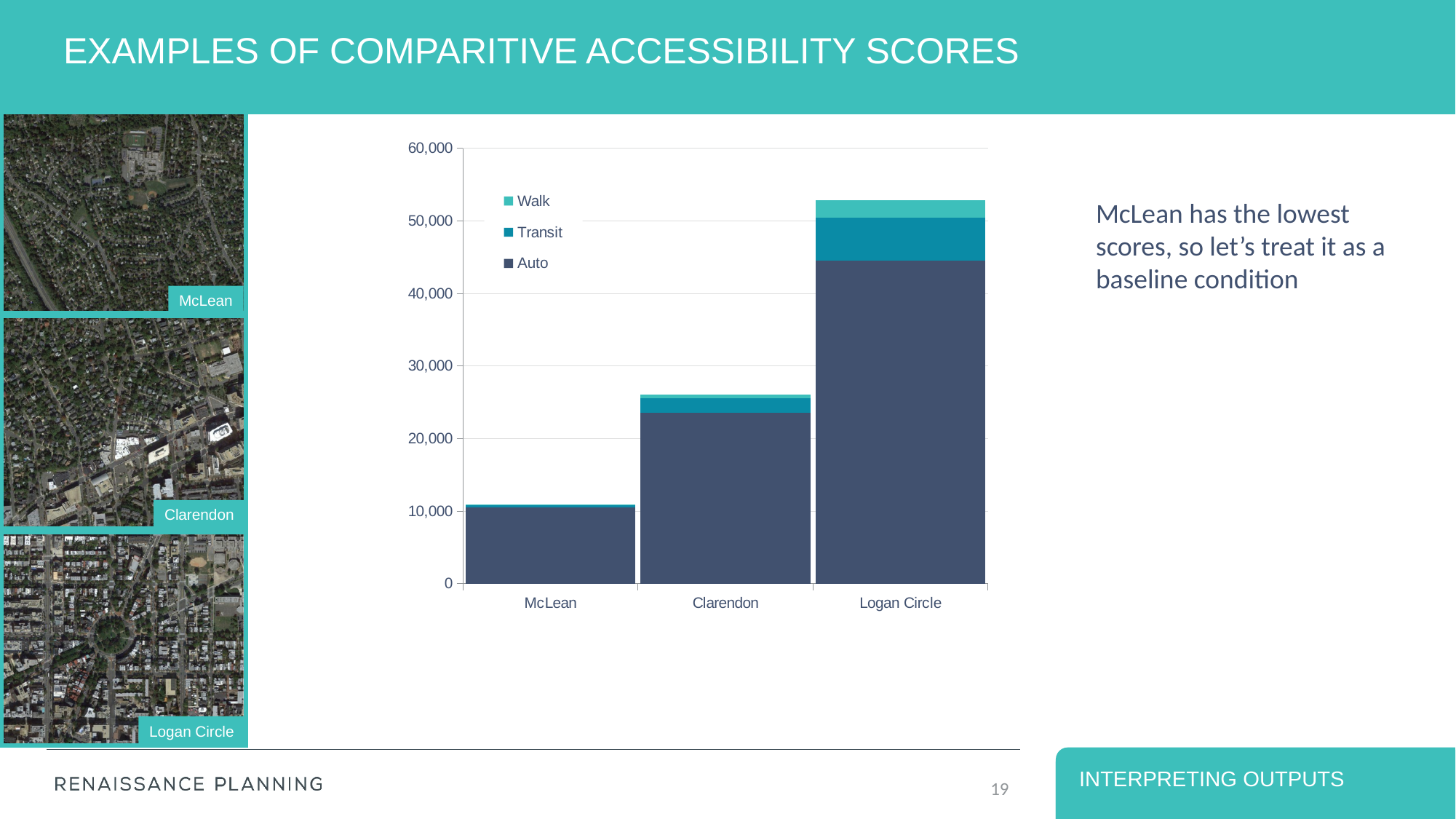
Is the total value for Clarendon greater or less than 30,000? less Which has a larger total score, Clarendon or McLean? Clarendon How many categories are shown on the x axis of the chart? 3 How many series does the chart's legend list? 3 Is the total value for McLean greater or less than 20,000? less Which category has the lowest total accessibility score? McLean Is the Auto value for Logan Circle greater or less than 40,000? greater Do the total scores rise or fall moving from McLean to Logan Circle along the x axis? Rise What kind of chart is shown on the slide? Stacked bar chart Which category has the highest total accessibility score? Logan Circle What are the three series listed in the chart's legend? Walk, Transit, Auto